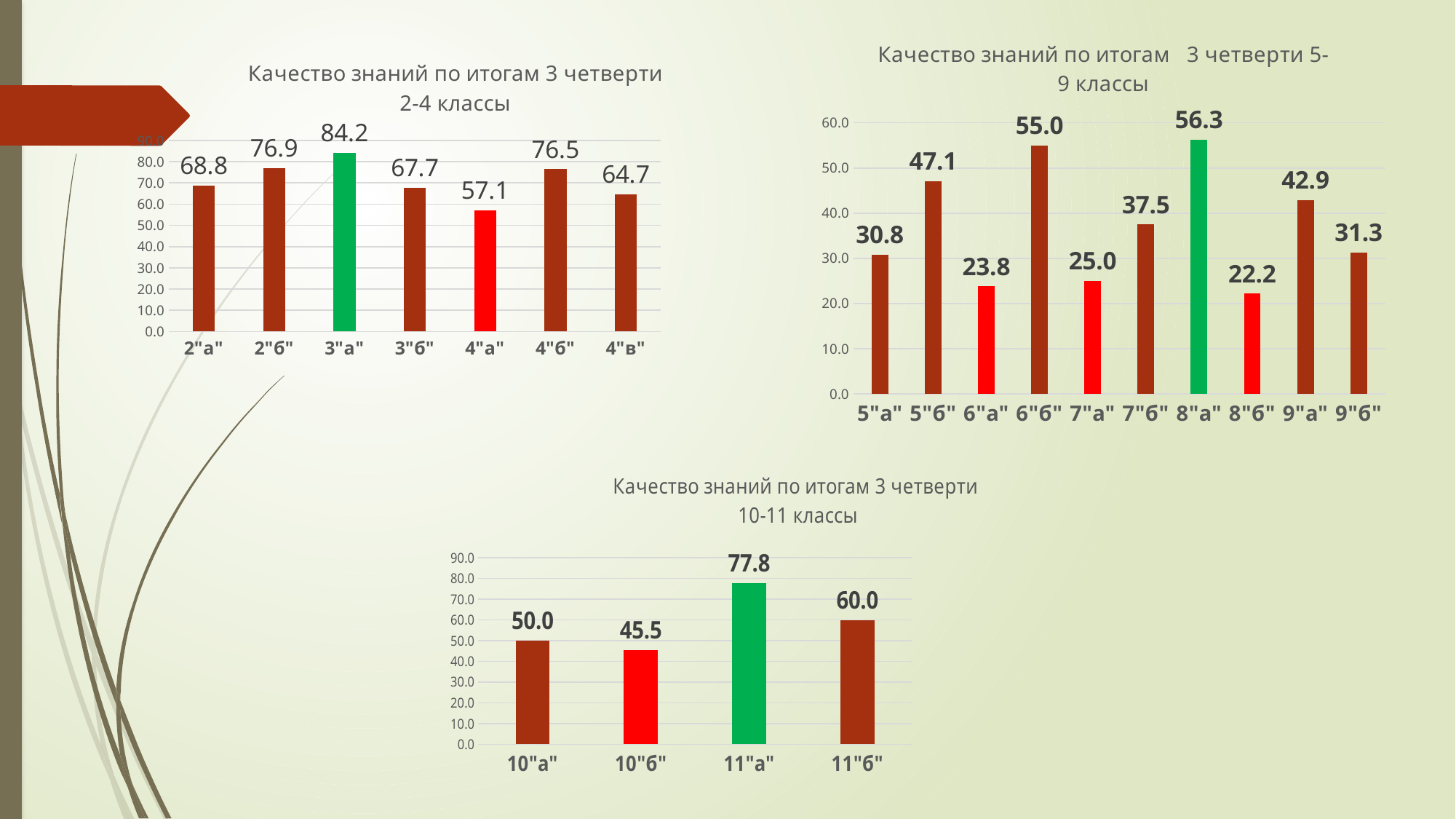
In the chart titled "Качество знаний по итогам 3 четверти 5-9 классы", how many classes are shown? 10 In the chart titled "Качество знаний по итогам 3 четверти 2-4 классы", what is the value for 3"а"? 84.2 What type of chart is the chart titled "Качество знаний по итогам 3 четверти 10-11 классы"? Bar chart In the chart titled "Качество знаний по итогам 3 четверти 10-11 классы", what is the value for 10"б"? 45.5 In the chart titled "Качество знаний по итогам 3 четверти 5-9 классы", which class has the lowest value? 8"б" In the chart titled "Качество знаний по итогам 3 четверти 2-4 классы", how many classes are shown? 7 In the chart titled "Качество знаний по итогам 3 четверти 2-4 классы", which class has the lowest value? 4"а" In the chart titled "Качество знаний по итогам 3 четверти 5-9 классы", what is the value for 7"б"? 37.5 In the chart titled "Качество знаний по итогам 3 четверти 5-9 классы", which is larger, the value for 5"б" or the value for 9"а"? 5"б" In the chart titled "Качество знаний по итогам 3 четверти 5-9 классы", which class has the highest value? 8"а" In the chart titled "Качество знаний по итогам 3 четверти 10-11 классы", what is the difference between the values for 11"а" and 11"б"? 17.8 In the chart titled "Качество знаний по итогам 3 четверти 2-4 классы", what is the difference between the values for 2"б" and 2"а"? 8.1